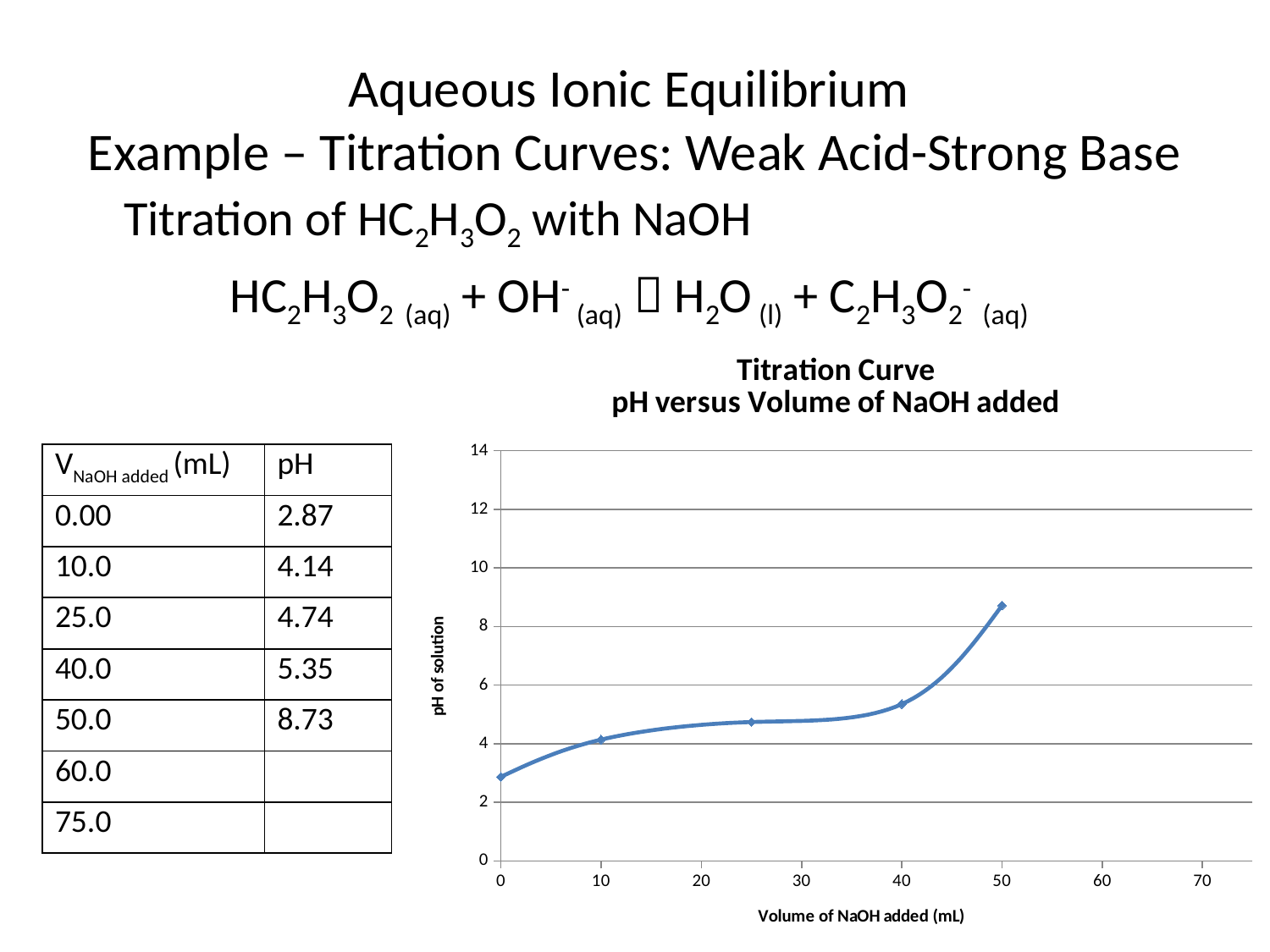
By how much does the pH increase between 40.0 mL and 50.0 mL of NaOH added? 3.38 At which volume of NaOH added is the plotted pH lowest? 0.00 mL How many data points are plotted on the titration curve? 5 What is the pH of the solution when 0.00 mL of NaOH has been added? 2.87 What is the title of the x axis of the chart? Volume of NaOH added (mL) Which has the higher pH: 25.0 mL or 40.0 mL of NaOH added? 40.0 mL What kind of chart is shown on the slide? line chart At which volume of NaOH added is the plotted pH highest? 50.0 mL Is the pH at 25 mL of NaOH added greater or less than 6? less What is the pH of the solution when 50.0 mL of NaOH has been added? 8.73 Is the pH at 50 mL of NaOH added greater or less than 8? greater Does the pH rise or fall as the volume of NaOH added increases? rises